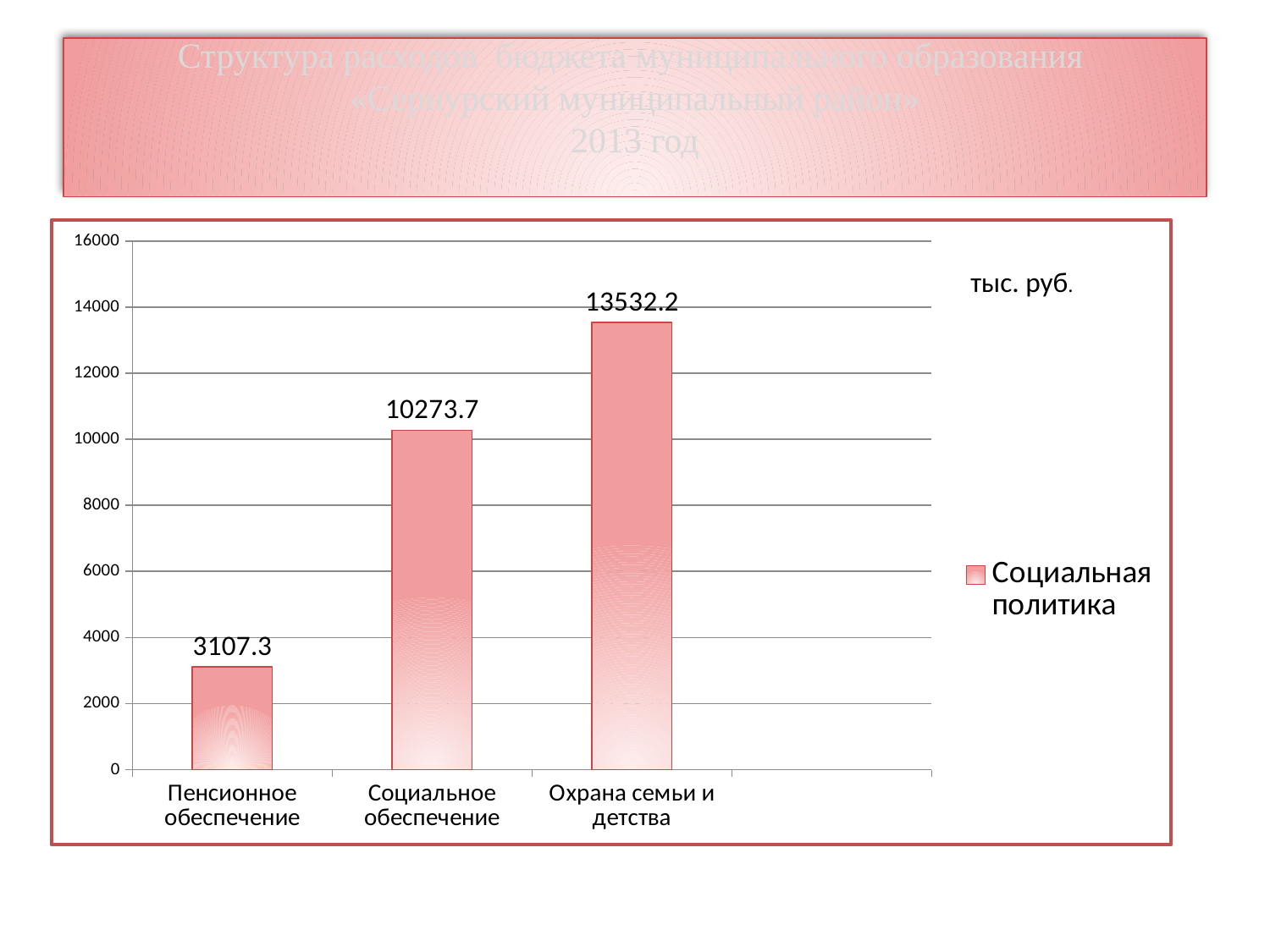
Which category has the lowest value? Пенсионное обеспечение What kind of chart is shown on the slide? bar chart Which category has the highest value? Охрана семьи и детства How many categories are shown on the x axis? 3 Which is larger, the value for Социальное обеспечение or the value for Пенсионное обеспечение? Социальное обеспечение What is the value for Охрана семьи и детства? 13532.2 Is the value for Охрана семьи и детства greater or less than 12000? greater What is the difference between the values for Социальное обеспечение and Пенсионное обеспечение? 7166.4 What is the value for Пенсионное обеспечение? 3107.3 What series name does the legend show? Социальная политика What is the difference between the values for Охрана семьи и детства and Социальное обеспечение? 3258.5 What is the value for Социальное обеспечение? 10273.7